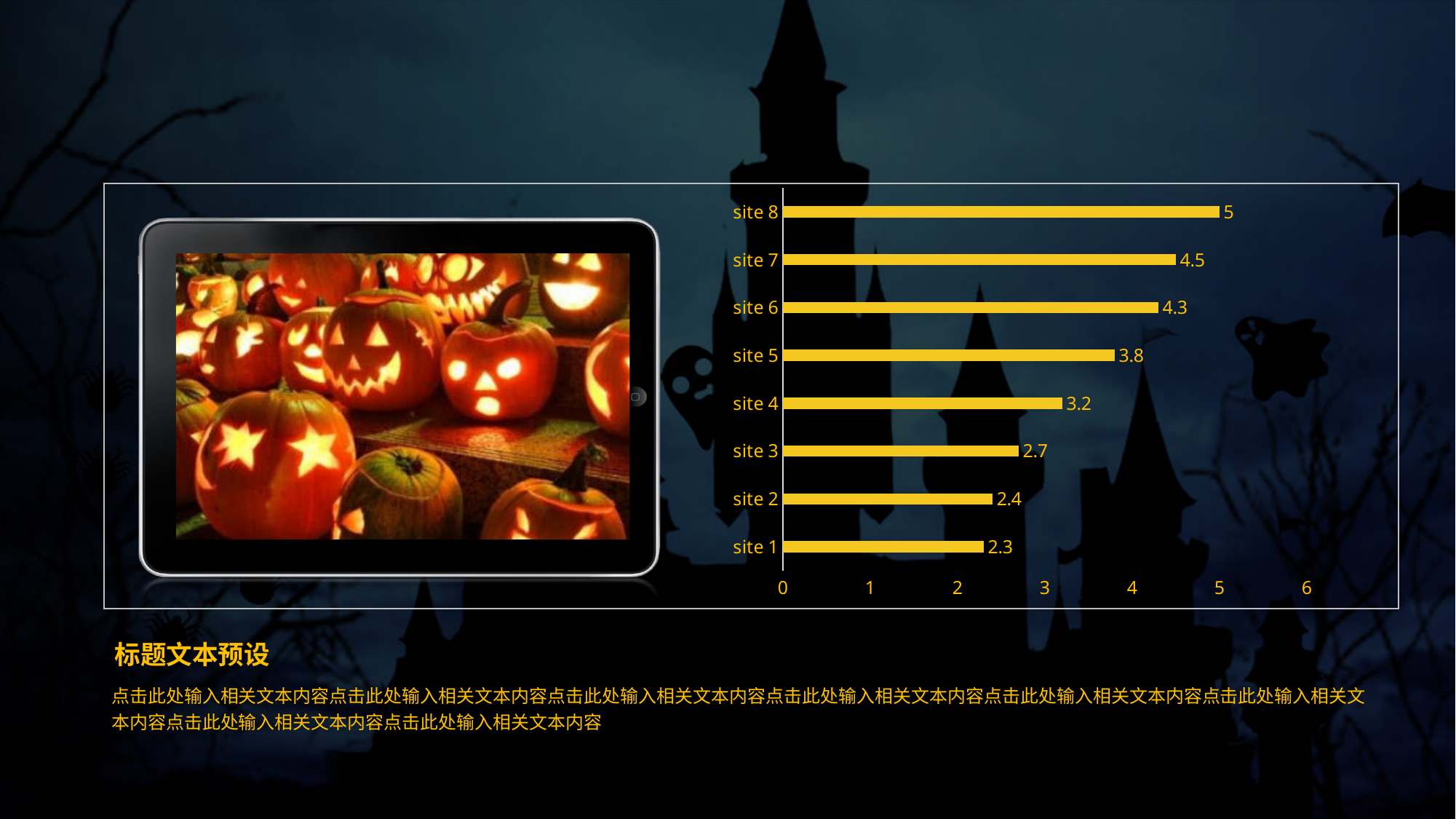
Which site has the lowest value? site 1 What colour are the bars in the chart? yellow Do the values increase or decrease from site 1 to site 8? increase Which has a larger value, site 6 or site 4? site 6 What is the value for site 1? 2.3 What is the difference between the values for site 7 and site 3? 1.8 Which site has the highest value? site 8 How many sites are shown in the chart? 8 What kind of chart is shown on the slide? bar chart What is the value for site 5? 3.8 What is the value for site 8? 5 Is the value for site 2 greater or less than 3? less